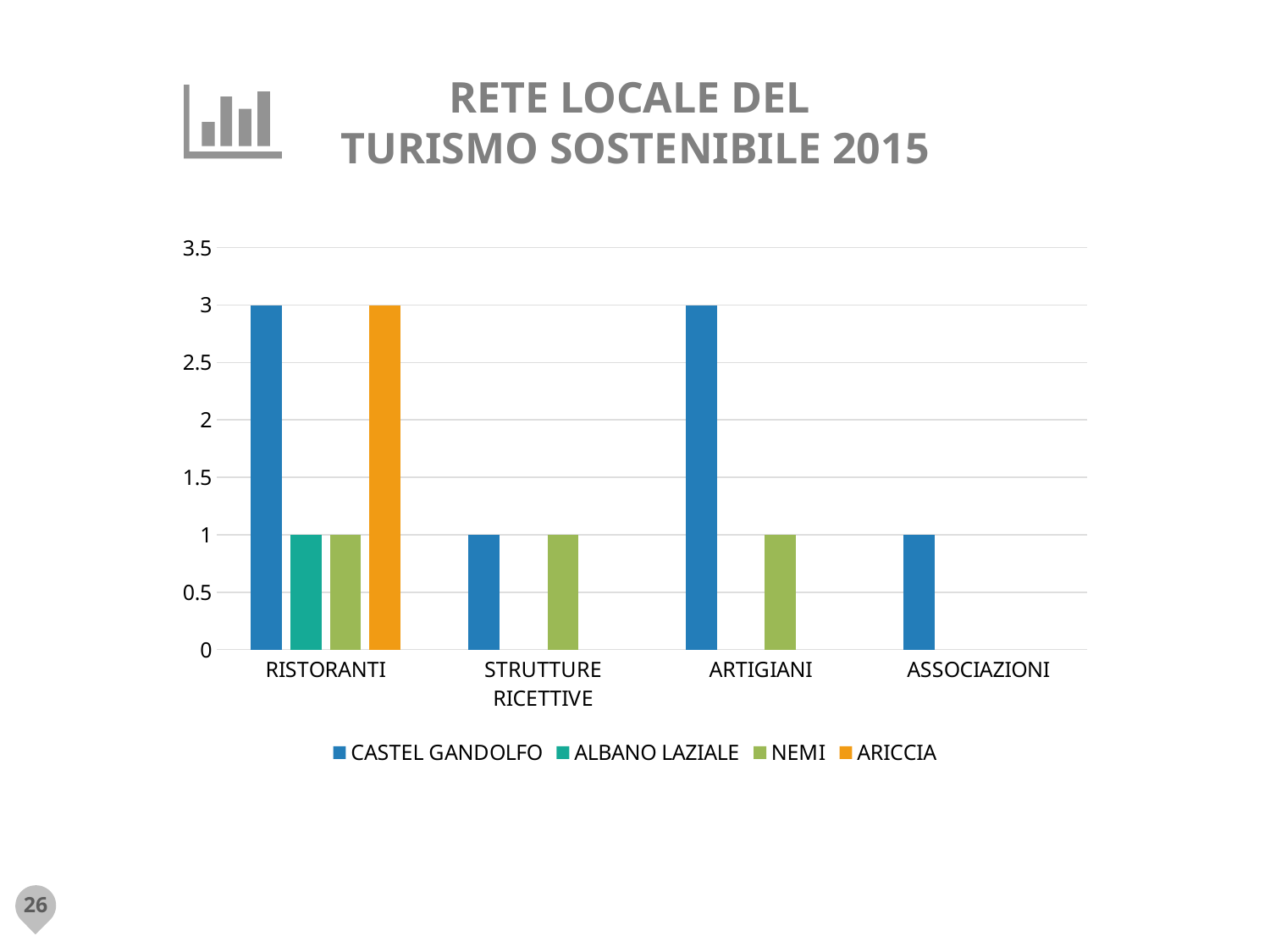
What is the value for CASTEL GANDOLFO in the ASSOCIAZIONI category? 1 What is the value for NEMI in the ARTIGIANI category? 1 In which category does CASTEL GANDOLFO have its lowest value? STRUTTURE RICETTIVE and ASSOCIAZIONI How many categories are shown on the x axis? 4 What is the value for ARICCIA in the RISTORANTI category? 3 Is the value for CASTEL GANDOLFO in the ARTIGIANI category greater or less than 2? greater What is the title of the chart? RETE LOCALE DEL TURISMO SOSTENIBILE 2015 Which is larger in the ARTIGIANI category, CASTEL GANDOLFO or NEMI? CASTEL GANDOLFO What is the difference between the CASTEL GANDOLFO value and the ALBANO LAZIALE value in the RISTORANTI category? 2 What is the value for CASTEL GANDOLFO in the RISTORANTI category? 3 How many series does the legend list? 4 What kind of chart is shown on the slide? bar chart